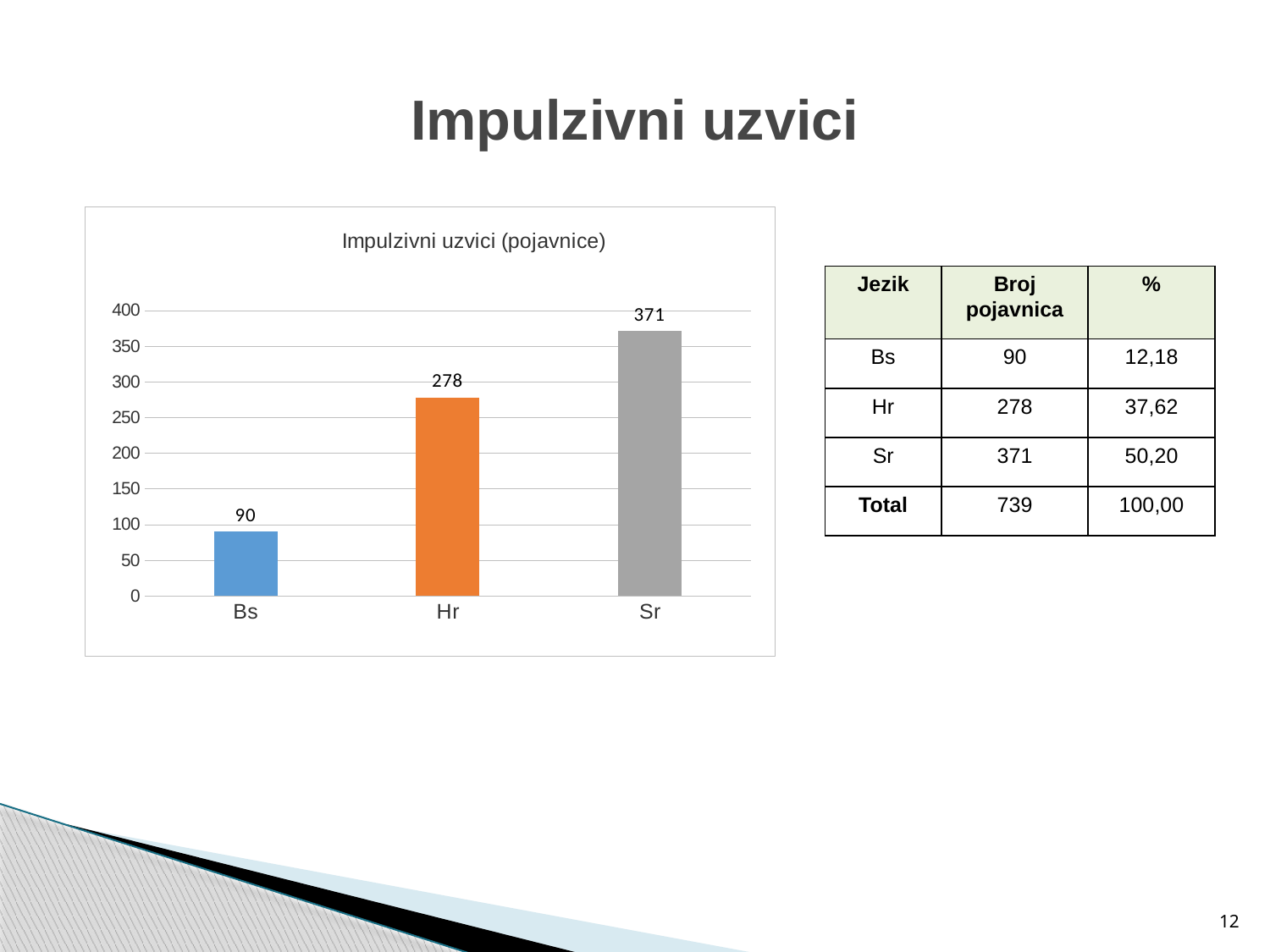
Which is larger, the value for Hr or the value for Bs? Hr What is the difference between the values for Hr and Bs? 188 What kind of chart is shown on the slide? bar chart What is the value for Bs in the chart? 90 Is the value for Sr greater or less than 350? greater Which category has the highest value in the chart? Sr What is the value for Sr in the chart? 371 What is the value for Hr in the chart? 278 What is the title of the chart? Impulzivni uzvici (pojavnice) Which category has the lowest value in the chart? Bs What is the difference between the values for Sr and Hr? 93 How many categories are shown in the chart? 3